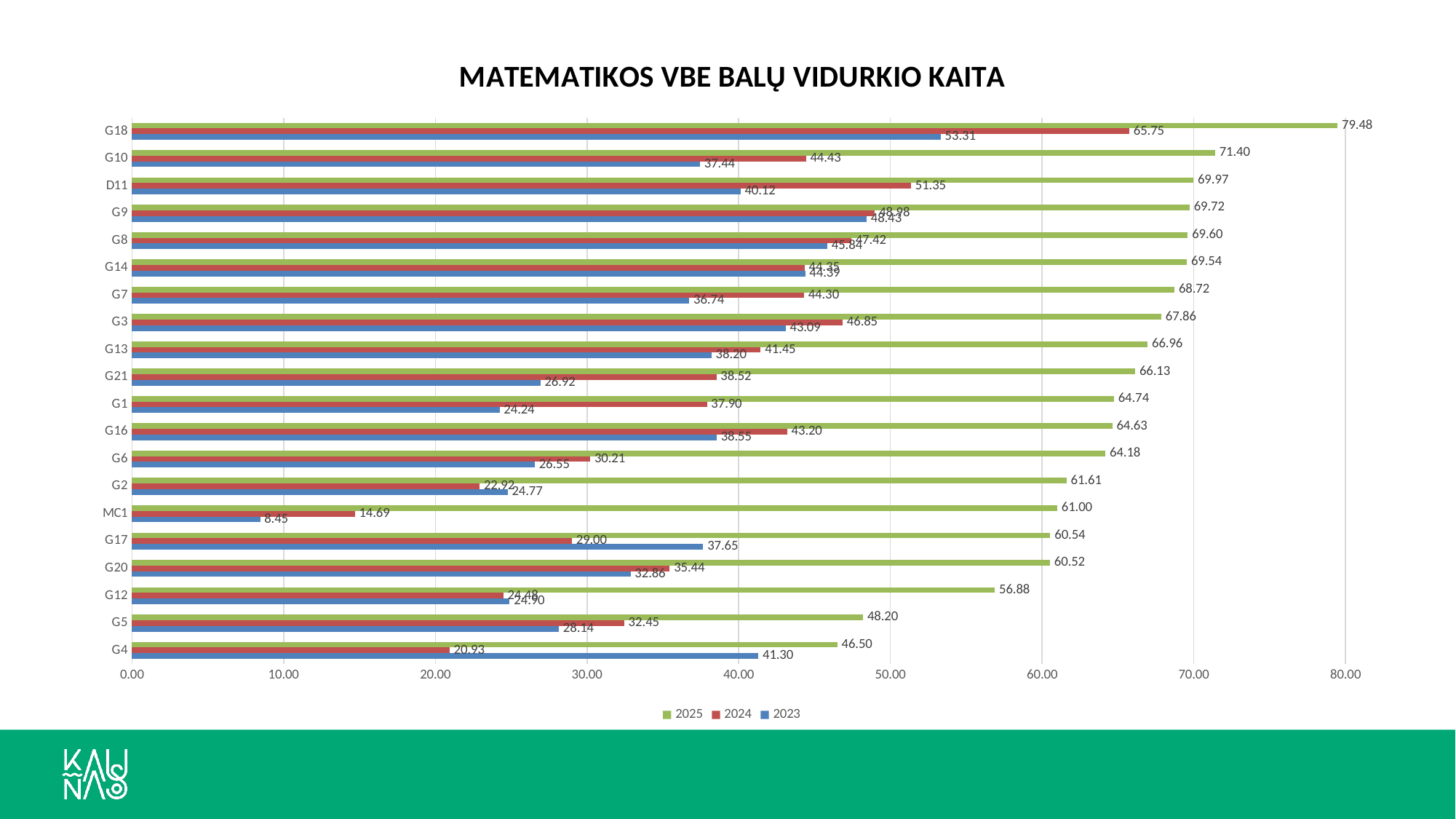
What is the 2025 value for G18? 79.48 Which is larger for G4: the 2023 value or the 2024 value? 2023 Which category has the highest 2025 value? G18 What kind of chart is shown on the slide? bar chart What is the title of the chart? MATEMATIKOS VBE BALŲ VIDURKIO KAITA What is the 2024 value for G10? 44.43 Which category has the lowest 2025 value? G4 What is the 2023 value for MC1? 8.45 What is the difference between the 2025 and 2024 values for G18? 13.73 How many series does the legend list? 3 Is the 2025 value for G12 greater or less than 60.00? less How many categories are shown on the y axis? 20